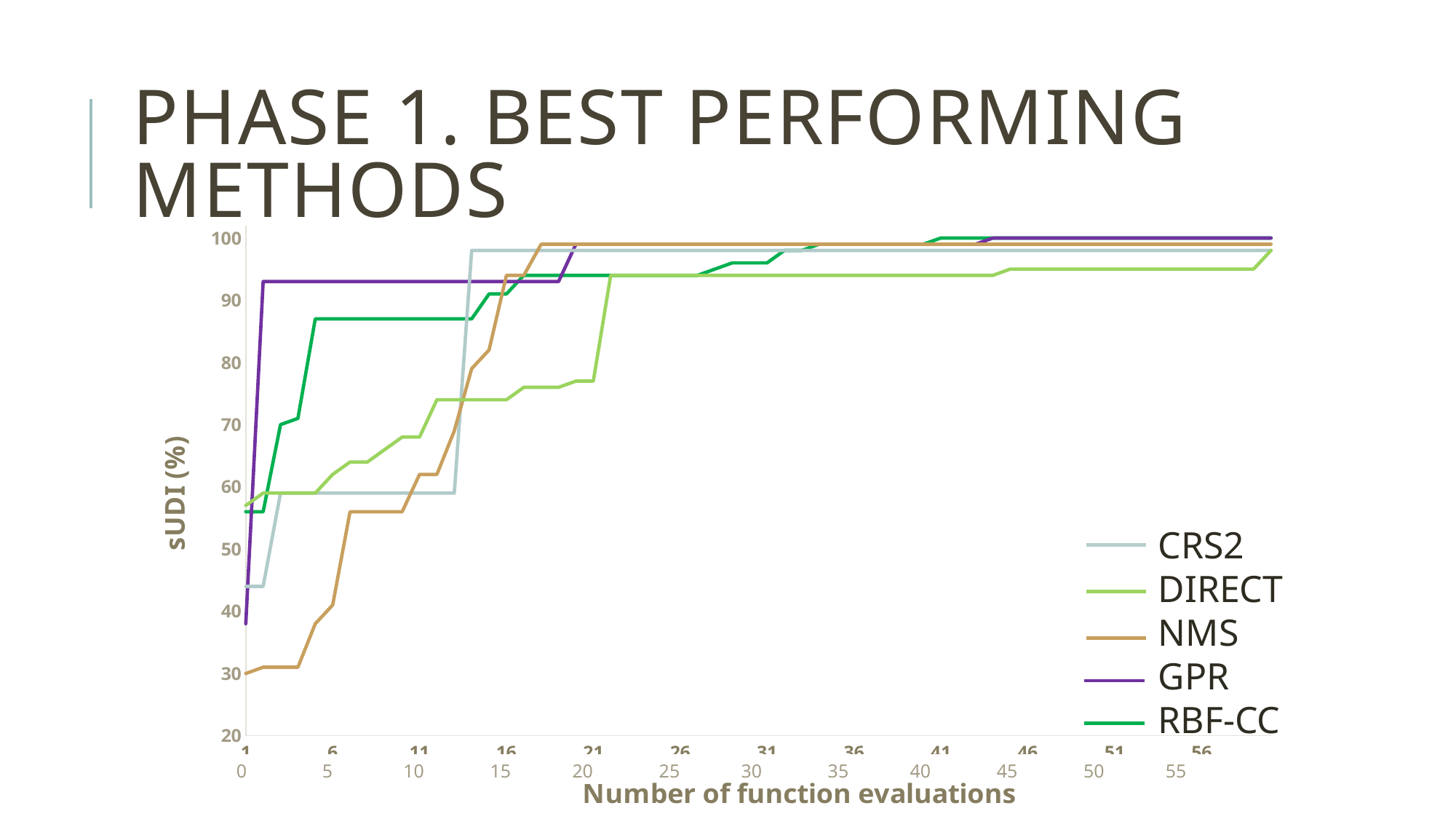
Is the value for NMS at 5 function evaluations greater or less than 50? less At 10 function evaluations, which series has the higher value, GPR or CRS2? GPR Is the value for GPR at 10 function evaluations greater or less than 90? greater What kind of chart is shown on the slide? line chart Is the value for CRS2 at 10 function evaluations greater or less than 70? less Do the sUDI values generally rise or fall as the number of function evaluations increases? rise What is the label of the y axis? sUDI (%) How many series does the legend list? 5 Which series has the lowest value at 0 function evaluations? NMS What is the label of the x axis? Number of function evaluations